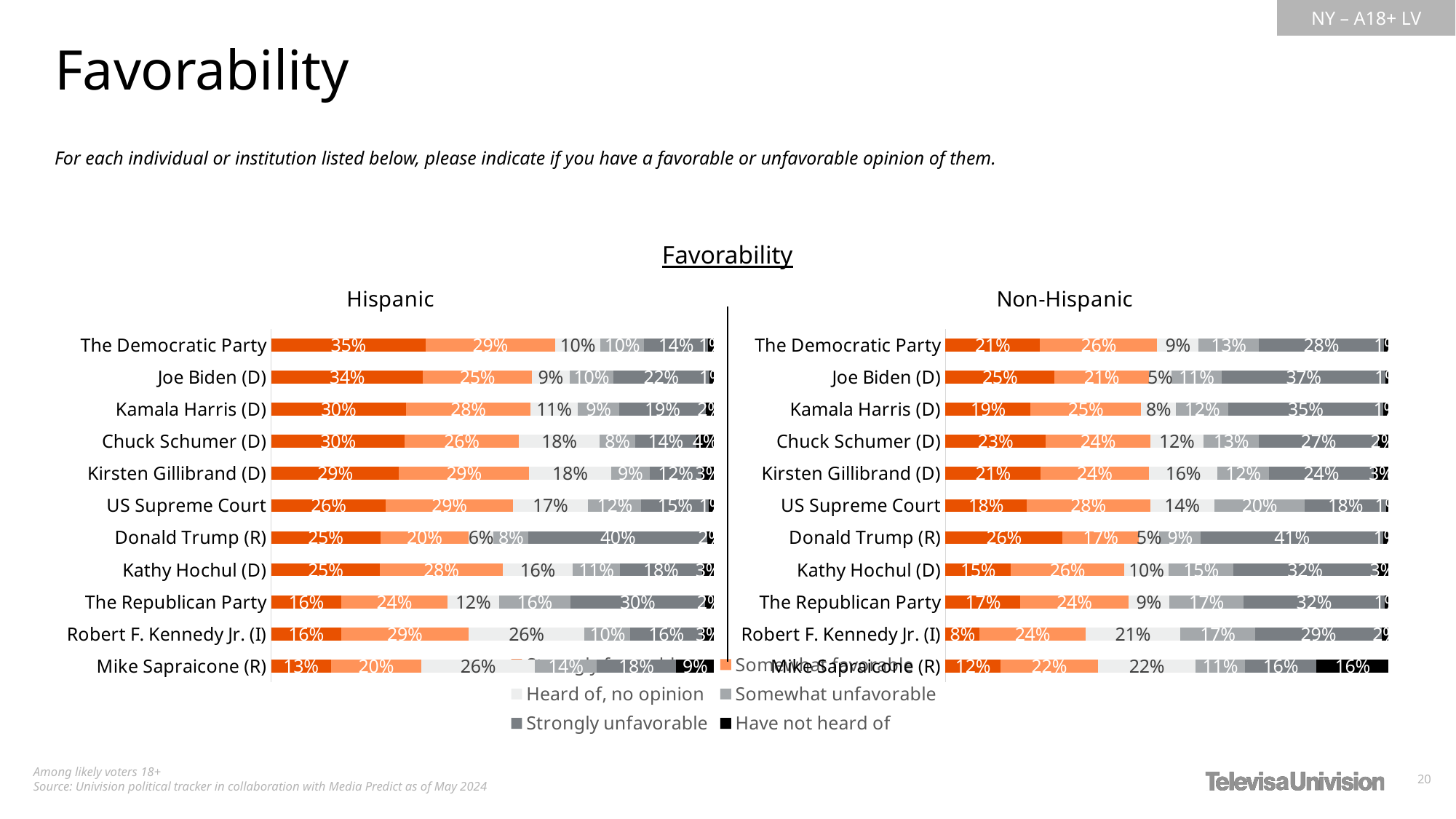
In the Non-Hispanic chart, what is the 'Have not heard of' value for Mike Sapraicone (R)? 16% In the Hispanic chart, what is the 'Heard of, no opinion' value for Robert F. Kennedy Jr. (I)? 26% In the Hispanic chart, what is the strongly favorable value for The Democratic Party? 35% In the Hispanic chart, which is larger: the strongly unfavorable value for Joe Biden (D) or for Kamala Harris (D)? Joe Biden (D) In the Hispanic chart, which individual or institution has the highest strongly unfavorable value? Donald Trump (R) In the Non-Hispanic chart, what is the somewhat favorable value for the US Supreme Court? 28% In the Non-Hispanic chart, what is the strongly unfavorable value for Donald Trump (R)? 41% How many individuals or institutions are listed in the Hispanic chart? 11 What is the difference between the strongly favorable values for Joe Biden (D) in the Hispanic chart and in the Non-Hispanic chart? 9% In the Non-Hispanic chart, which individual or institution has the lowest strongly favorable value? Robert F. Kennedy Jr. (I) What kind of chart is used for the Non-Hispanic data? Stacked bar chart How many series does the legend list? 6